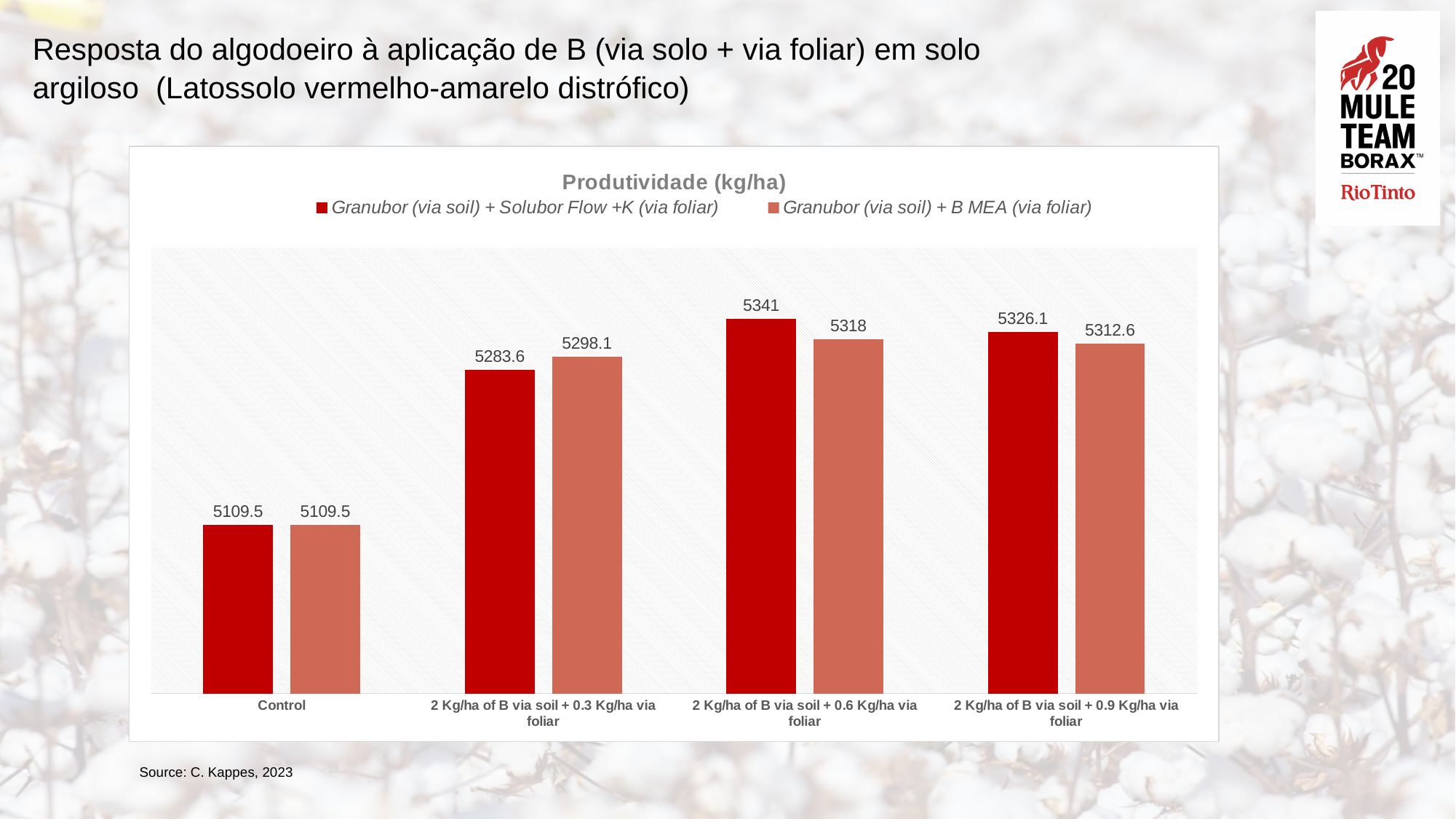
What kind of chart is shown on the slide? Bar chart What is the value for the Granubor (via soil) + Solubor Flow +K (via foliar) series at 2 Kg/ha of B via soil + 0.6 Kg/ha via foliar? 5341 What is the value for the Granubor (via soil) + B MEA (via foliar) series at 2 Kg/ha of B via soil + 0.3 Kg/ha via foliar? 5298.1 At 2 Kg/ha of B via soil + 0.3 Kg/ha via foliar, which series has the larger value? Granubor (via soil) + B MEA (via foliar) How many series does the legend list? 2 Which category has the highest value for the Granubor (via soil) + Solubor Flow +K (via foliar) series? 2 Kg/ha of B via soil + 0.6 Kg/ha via foliar What is the difference between the Granubor (via soil) + Solubor Flow +K (via foliar) value at 2 Kg/ha of B via soil + 0.6 Kg/ha via foliar and its Control value? 231.5 What is the value for the Control category in the Granubor (via soil) + B MEA (via foliar) series? 5109.5 What is the difference between the two series at 2 Kg/ha of B via soil + 0.6 Kg/ha via foliar? 23 What is the value for the Granubor (via soil) + Solubor Flow +K (via foliar) series at 2 Kg/ha of B via soil + 0.9 Kg/ha via foliar? 5326.1 How many categories are shown on the x axis? 4 Which category has the lowest value for the Granubor (via soil) + B MEA (via foliar) series? Control